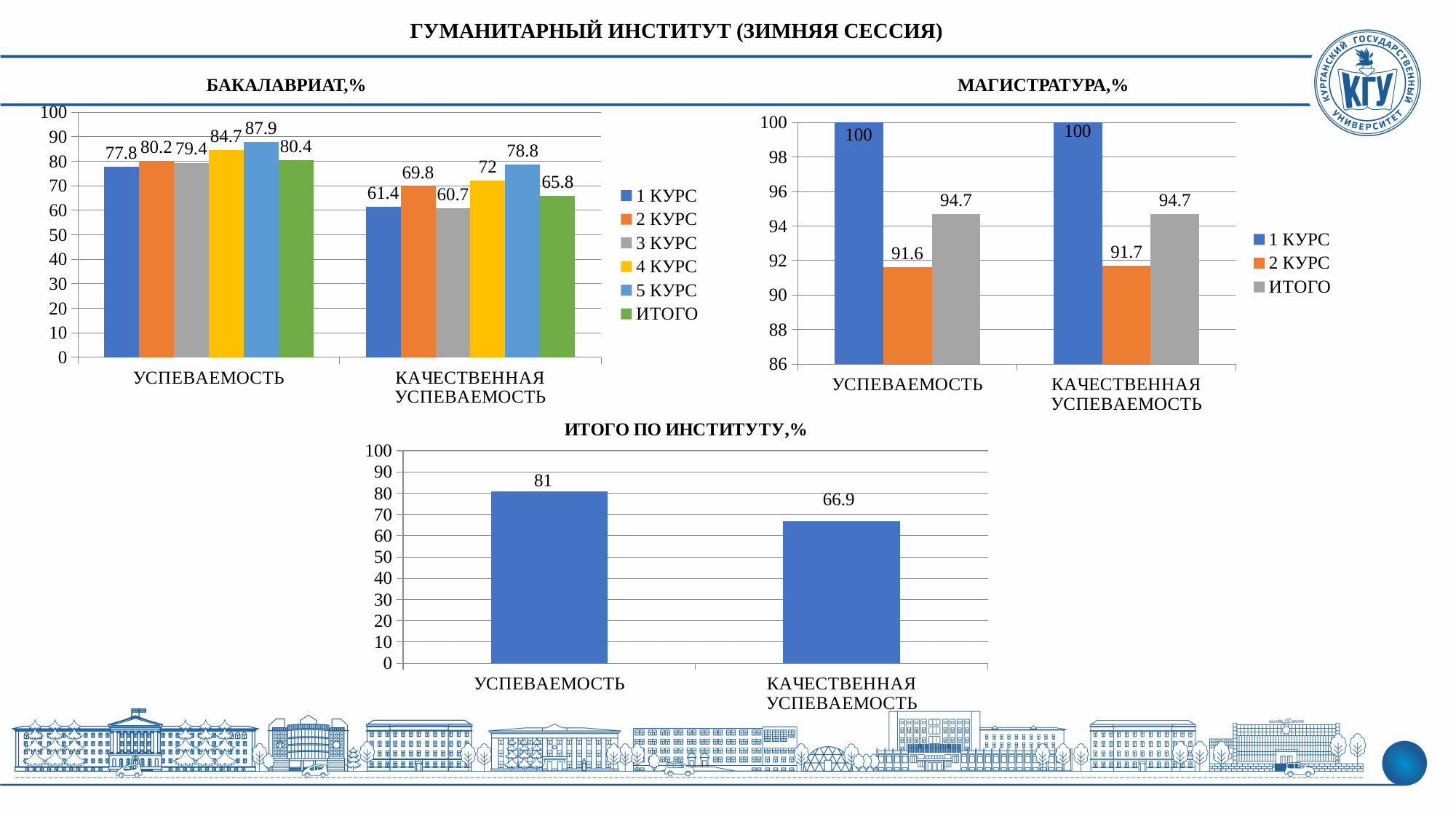
How many series does the legend of the БАКАЛАВРИАТ,% chart list? 6 In the МАГИСТРАТУРА,% chart, what is the value for 2 КУРС in the КАЧЕСТВЕННАЯ УСПЕВАЕМОСТЬ category? 91.7 In the БАКАЛАВРИАТ,% chart, what is the difference between the 4 КУРС and 1 КУРС values in the УСПЕВАЕМОСТЬ category? 6.9 What kind of chart is the ИТОГО ПО ИНСТИТУТУ,% chart? Bar chart In the МАГИСТРАТУРА,% chart, which is larger in the УСПЕВАЕМОСТЬ category: 1 КУРС or 2 КУРС? 1 КУРС In the ИТОГО ПО ИНСТИТУТУ,% chart, what is the difference between УСПЕВАЕМОСТЬ and КАЧЕСТВЕННАЯ УСПЕВАЕМОСТЬ? 14.1 In the МАГИСТРАТУРА,% chart, what is the value for ИТОГО in the УСПЕВАЕМОСТЬ category? 94.7 In the БАКАЛАВРИАТ,% chart, what is the value for 3 КУРС in the КАЧЕСТВЕННАЯ УСПЕВАЕМОСТЬ category? 60.7 In the БАКАЛАВРИАТ,% chart, which series has the highest value in the КАЧЕСТВЕННАЯ УСПЕВАЕМОСТЬ category? 5 КУРС In the БАКАЛАВРИАТ,% chart, which series has the lowest value in the УСПЕВАЕМОСТЬ category? 1 КУРС In the ИТОГО ПО ИНСТИТУТУ,% chart, what is the value for КАЧЕСТВЕННАЯ УСПЕВАЕМОСТЬ? 66.9 In the БАКАЛАВРИАТ,% chart, what is the value for 5 КУРС in the УСПЕВАЕМОСТЬ category? 87.9